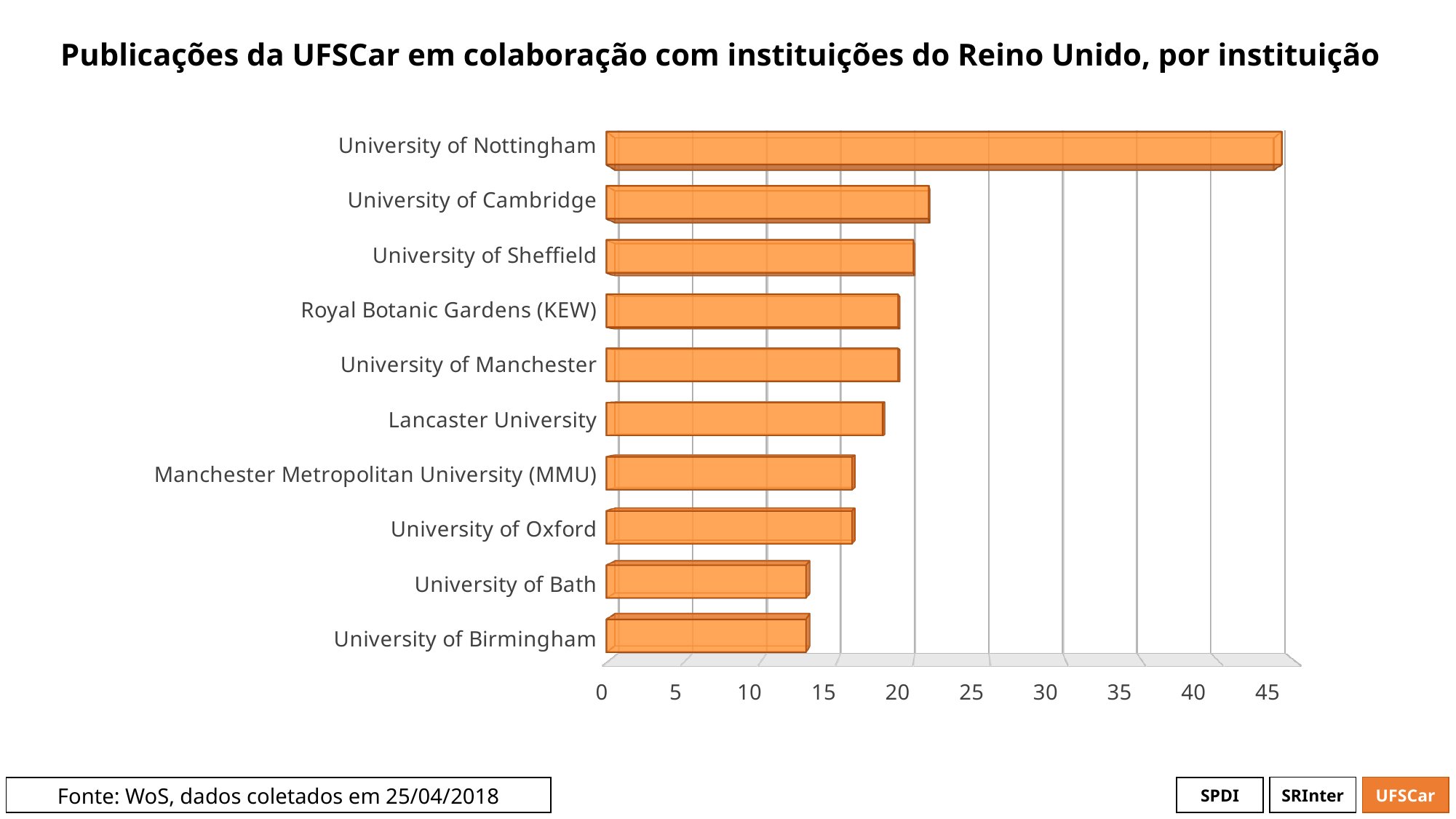
How many institutions are listed on the chart? 10 Which has more publications with UFSCar: University of Sheffield or University of Birmingham? University of Sheffield What colour are the bars in the chart? orange Which institution has the highest number of publications in collaboration with UFSCar? University of Nottingham What is the title of the chart? Publicações da UFSCar em colaboração com instituições do Reino Unido, por instituição Is the value for University of Cambridge greater or less than 20? greater Is the value for Manchester Metropolitan University (MMU) greater or less than 15? greater Which has more publications with UFSCar: University of Nottingham or University of Cambridge? University of Nottingham Is the value for University of Nottingham greater or less than 40? greater What kind of chart is shown on the slide? bar chart